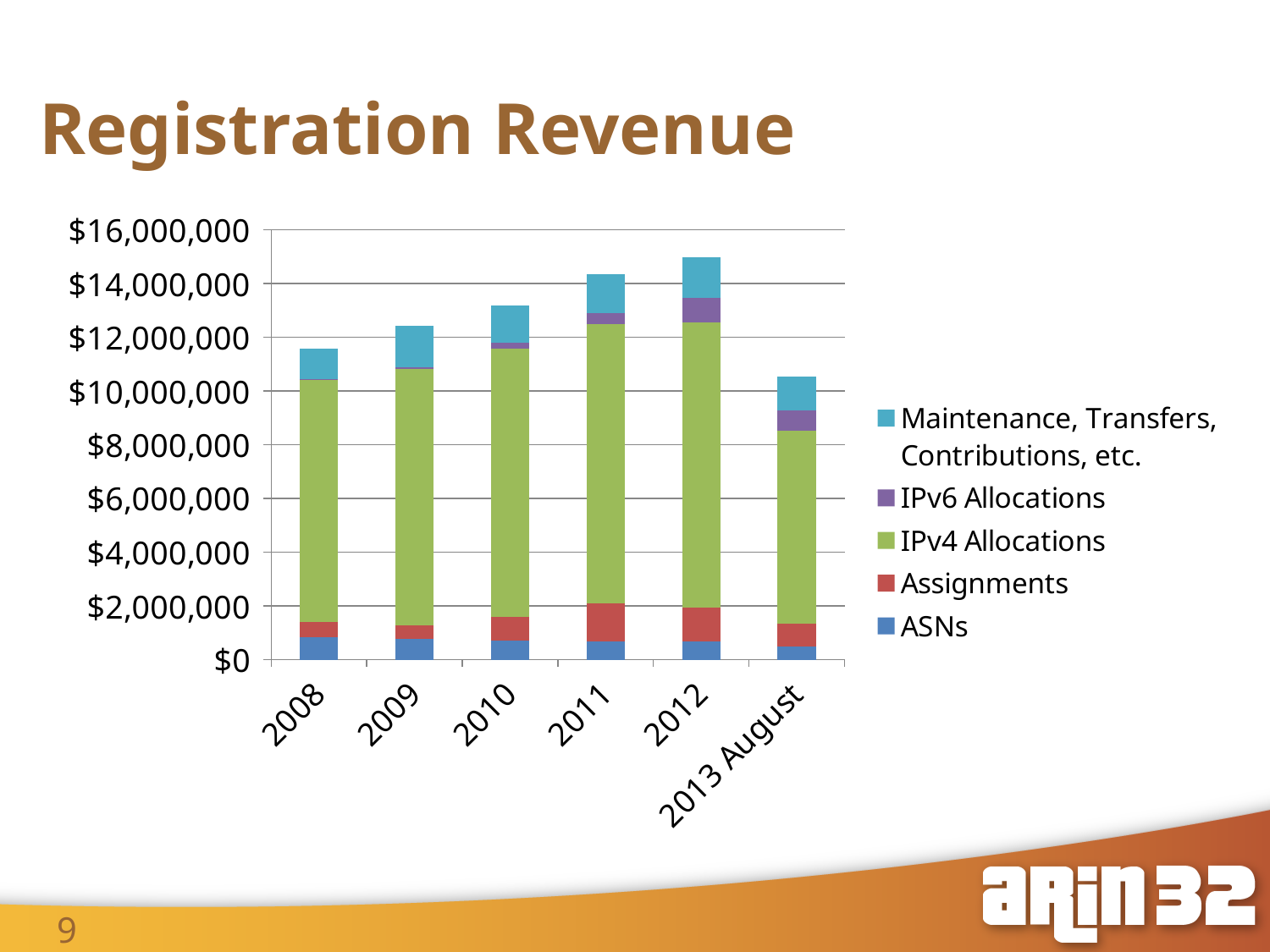
Which year has the highest total registration revenue? 2012 What kind of chart is shown on the slide? Stacked bar chart How many series does the legend list? 5 Which has a larger total revenue, 2010 or 2011? 2011 Do the total revenues rise or fall from 2008 to 2012? Rise Is the total revenue for 2008 greater or less than $12,000,000? less Which category has the lowest total registration revenue? 2013 August Is the total revenue for 2012 greater or less than $14,000,000? greater What is the title of the chart? Registration Revenue How many categories are shown along the x axis? 6 Is the total revenue for 2013 August greater or less than $10,000,000? greater Which series makes up the largest portion of each bar? IPv4 Allocations